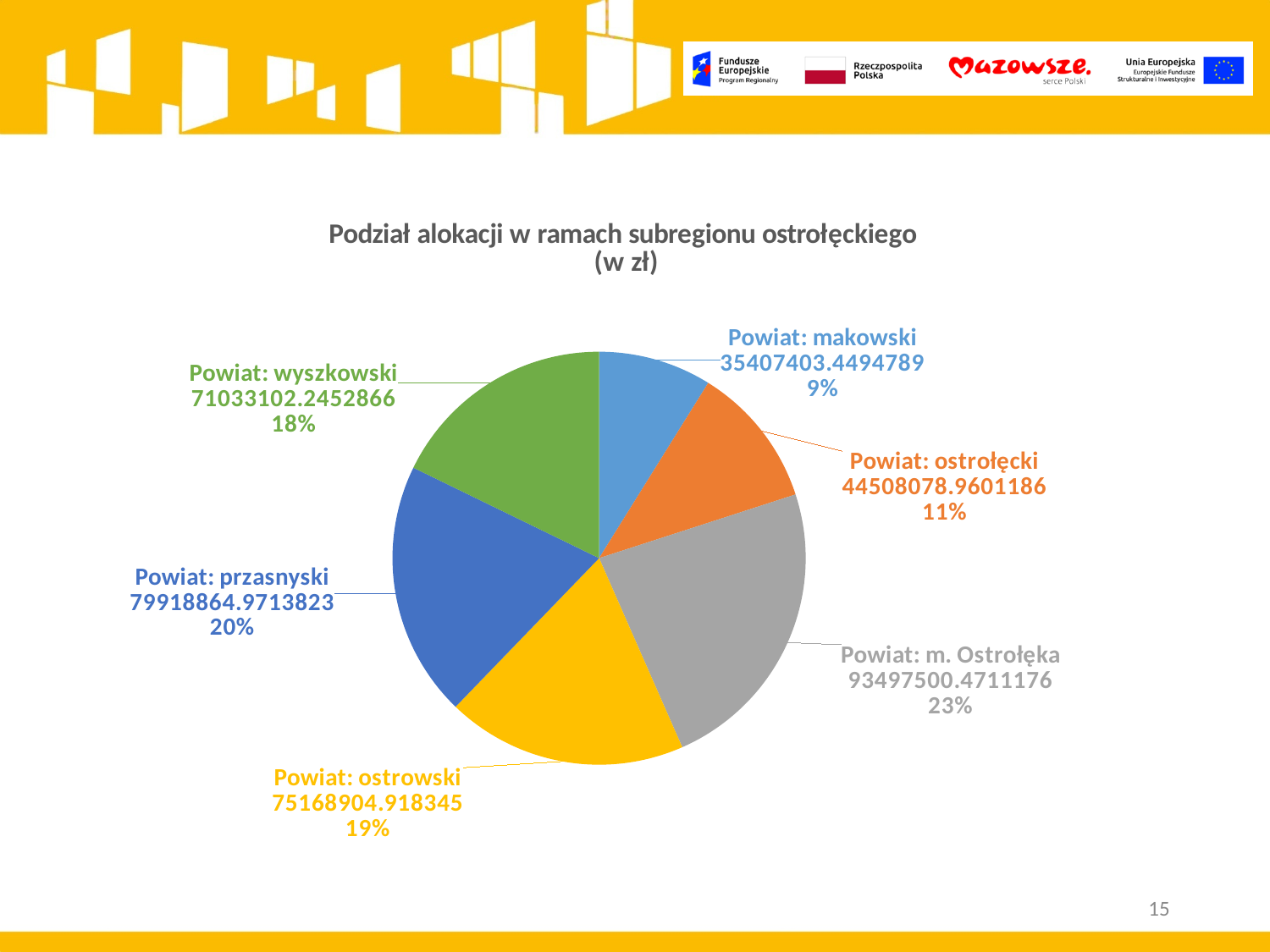
What share of the pie does Powiat: ostrołęcki represent? 11% What is the allocation value for Powiat: makowski? 35407403.4494789 What is the difference between the allocation for Powiat: przasnyski and Powiat: ostrowski? 4749960.0530373 Which powiat has the largest share of the allocation? Powiat: m. Ostrołęka How many slices does the pie chart have? 6 What is the allocation value for Powiat: wyszkowski? 71033102.2452866 Which powiat has the smallest share of the allocation? Powiat: makowski What is the title of the chart? Podział alokacji w ramach subregionu ostrołęckiego (w zł) What is the allocation value for Powiat: m. Ostrołęka? 93497500.4711176 What share of the pie does Powiat: ostrowski represent? 19% Which is larger, the allocation for Powiat: przasnyski or for Powiat: ostrowski? Powiat: przasnyski What kind of chart is shown on the slide? pie chart